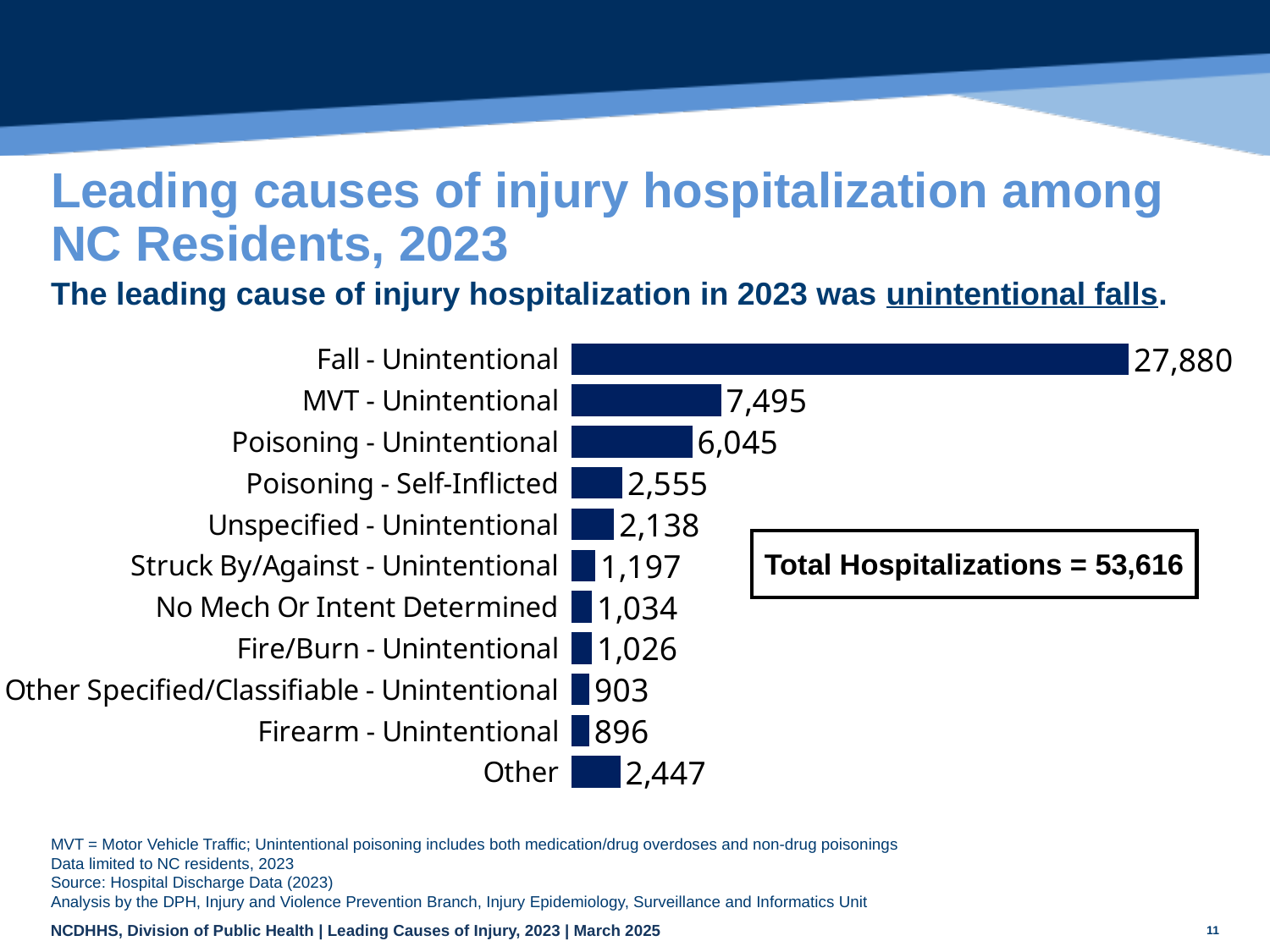
Which is larger, Unspecified - Unintentional or Other? Other What is the value for Poisoning - Self-Inflicted? 2,555 What is the value for No Mech Or Intent Determined? 1,034 What total number of hospitalizations is stated on the slide? 53,616 What is the difference between MVT - Unintentional and Poisoning - Unintentional? 1,450 What is the value for Firearm - Unintentional? 896 What kind of chart is shown on the slide? Bar chart What is the value for Fall - Unintentional? 27,880 How many categories are shown in the chart? 11 Which category has the lowest value? Firearm - Unintentional Which category has the highest value? Fall - Unintentional What is the difference between Fall - Unintentional and MVT - Unintentional? 20,385